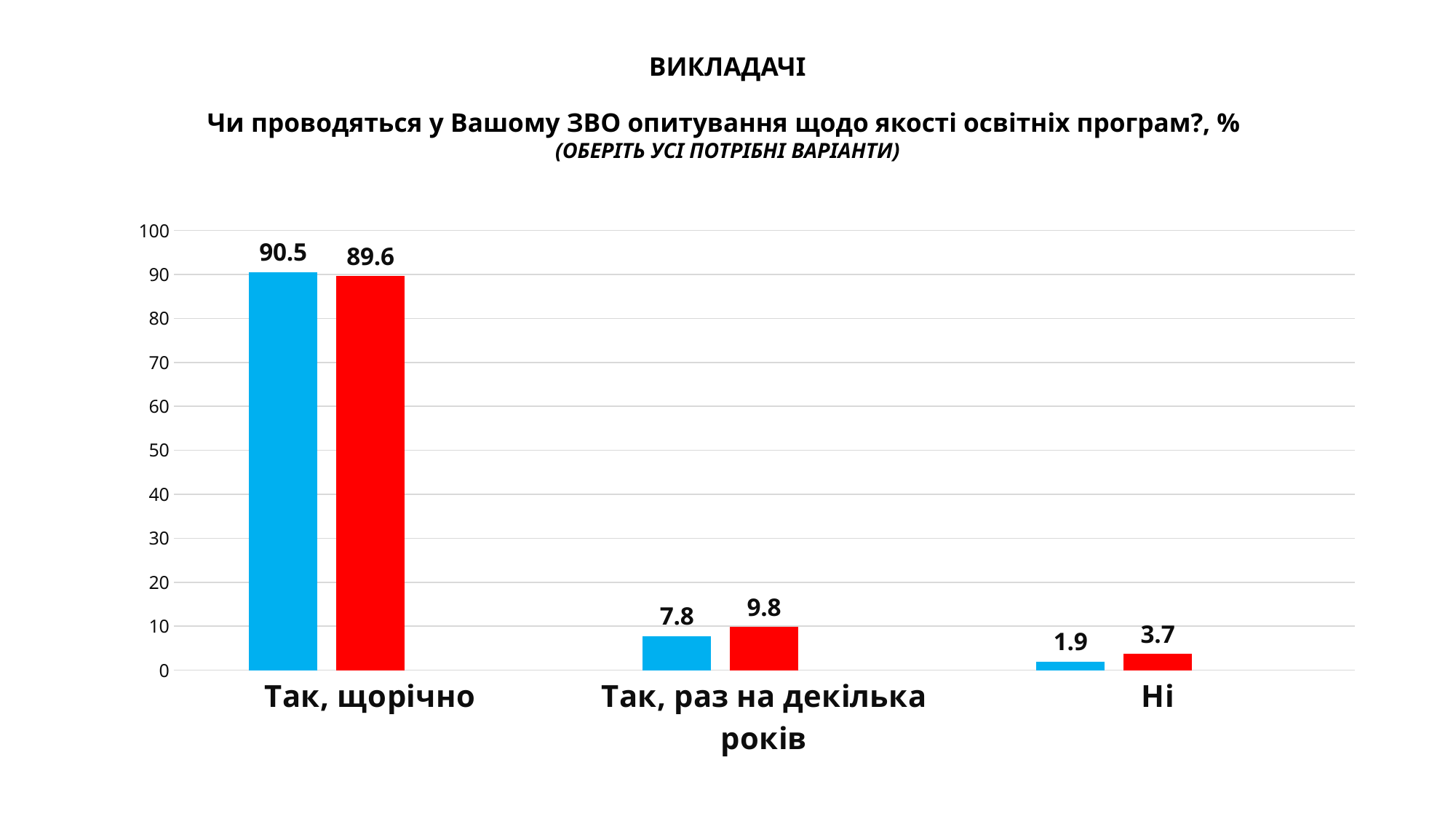
For "Ні", which bar is larger, the blue or the red one? red What is the heading shown above the chart title? ВИКЛАДАЧІ What is the difference between the red and blue bars for "Так, раз на декілька років"? 2.0 What is the difference between the blue and red bars for "Так, щорічно"? 0.9 Which category has the highest values? Так, щорічно What is the value of the blue bar for "Так, раз на декілька років"? 7.8 What kind of chart is shown on the slide? bar chart How many categories are shown on the x axis? 3 Which category has the lowest values? Ні What is the value of the blue bar for "Так, щорічно"? 90.5 What is the value of the red bar for "Так, щорічно"? 89.6 What is the value of the red bar for "Ні"? 3.7